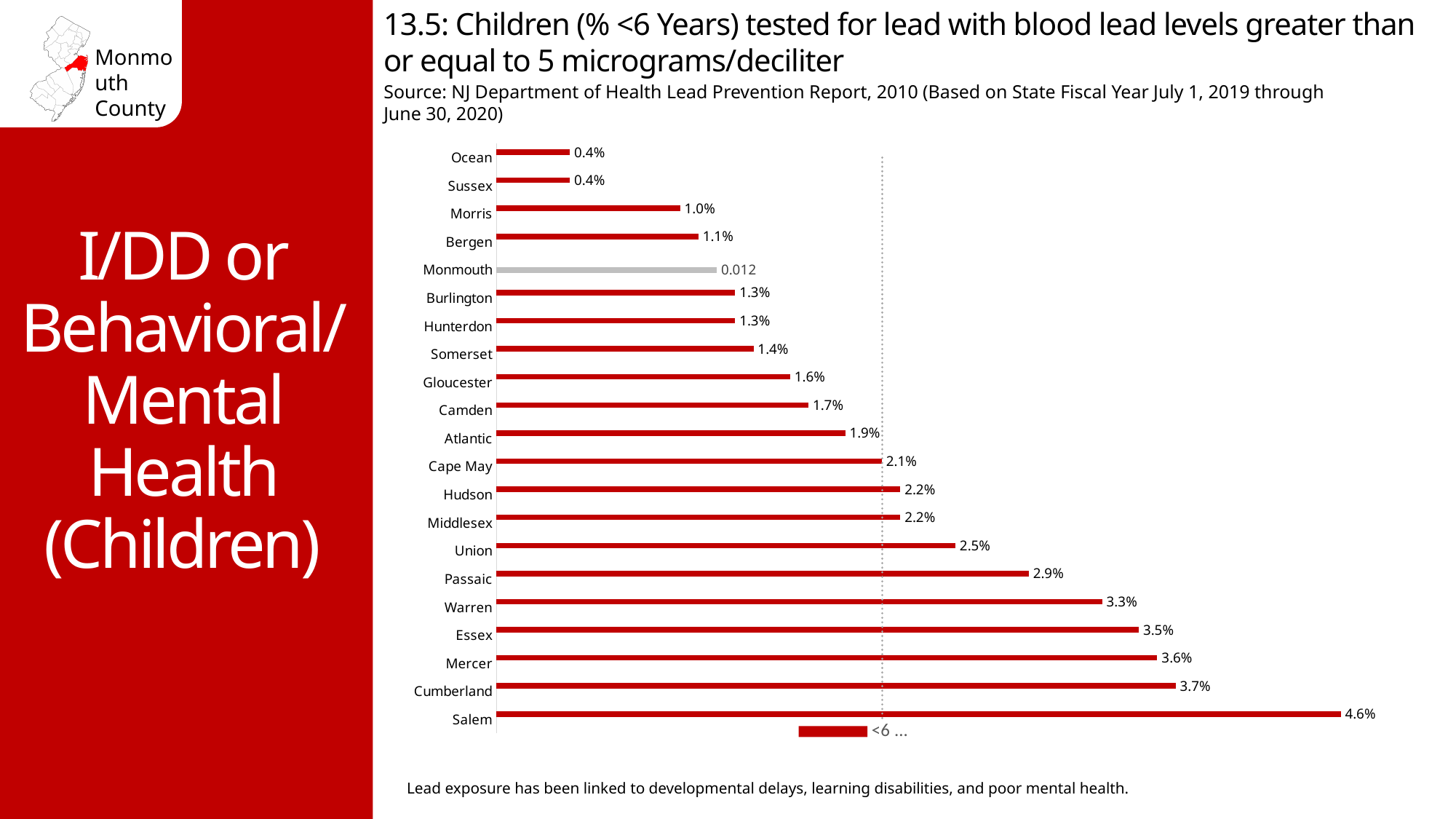
What type of chart is shown on the slide? bar chart How many counties are plotted in the chart? 21 What is the value shown for Passaic? 2.9% Which county has the highest value in the chart? Salem What is the value shown for Gloucester? 1.6% What is the value shown for Salem? 4.6% What is the difference between the values for Salem and Cumberland? 0.9% Which has a larger value, Morris or Somerset? Somerset What is the value shown for Monmouth? 0.012 Which has a larger value, Union or Passaic? Passaic What colour is the bar for Monmouth? gray What is the difference between the values for Essex and Warren? 0.2%